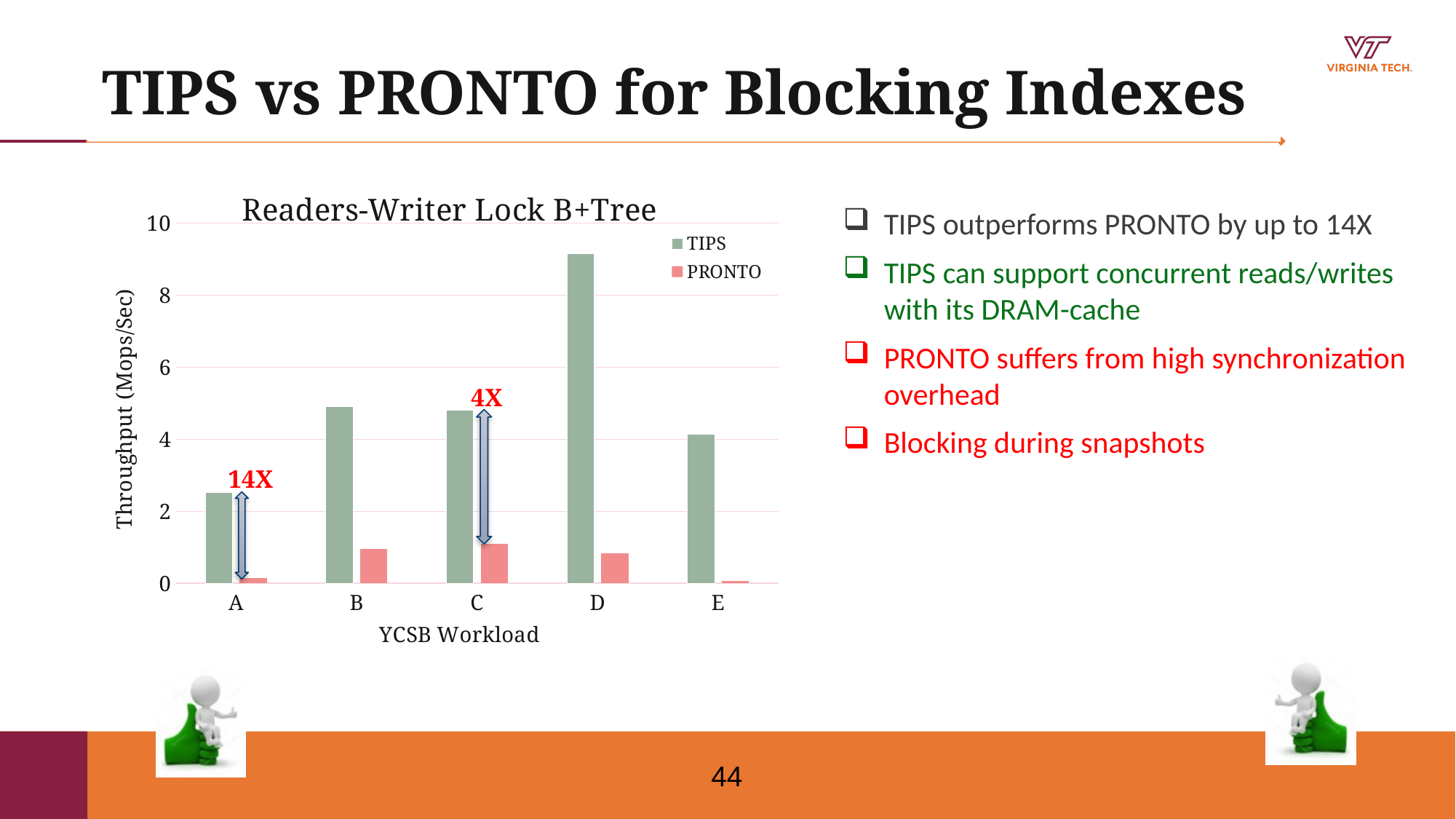
Is the TIPS throughput for workload A greater or less than 2? greater For workload D, which series has the larger throughput, TIPS or PRONTO? TIPS Is the PRONTO throughput for workload B greater or less than 2? less What kind of chart is shown on the slide? bar chart Is the TIPS throughput for workload D greater or less than 8? greater For which YCSB workload is the TIPS throughput lowest? A How many YCSB workload categories are shown on the x axis? 5 For which YCSB workload is the PRONTO throughput lowest? E How many series does the chart's legend list? 2 For which YCSB workload is the TIPS throughput highest? D What speedup annotation is shown above workload A in the chart? 14X What is the title of the chart? Readers-Writer Lock B+Tree